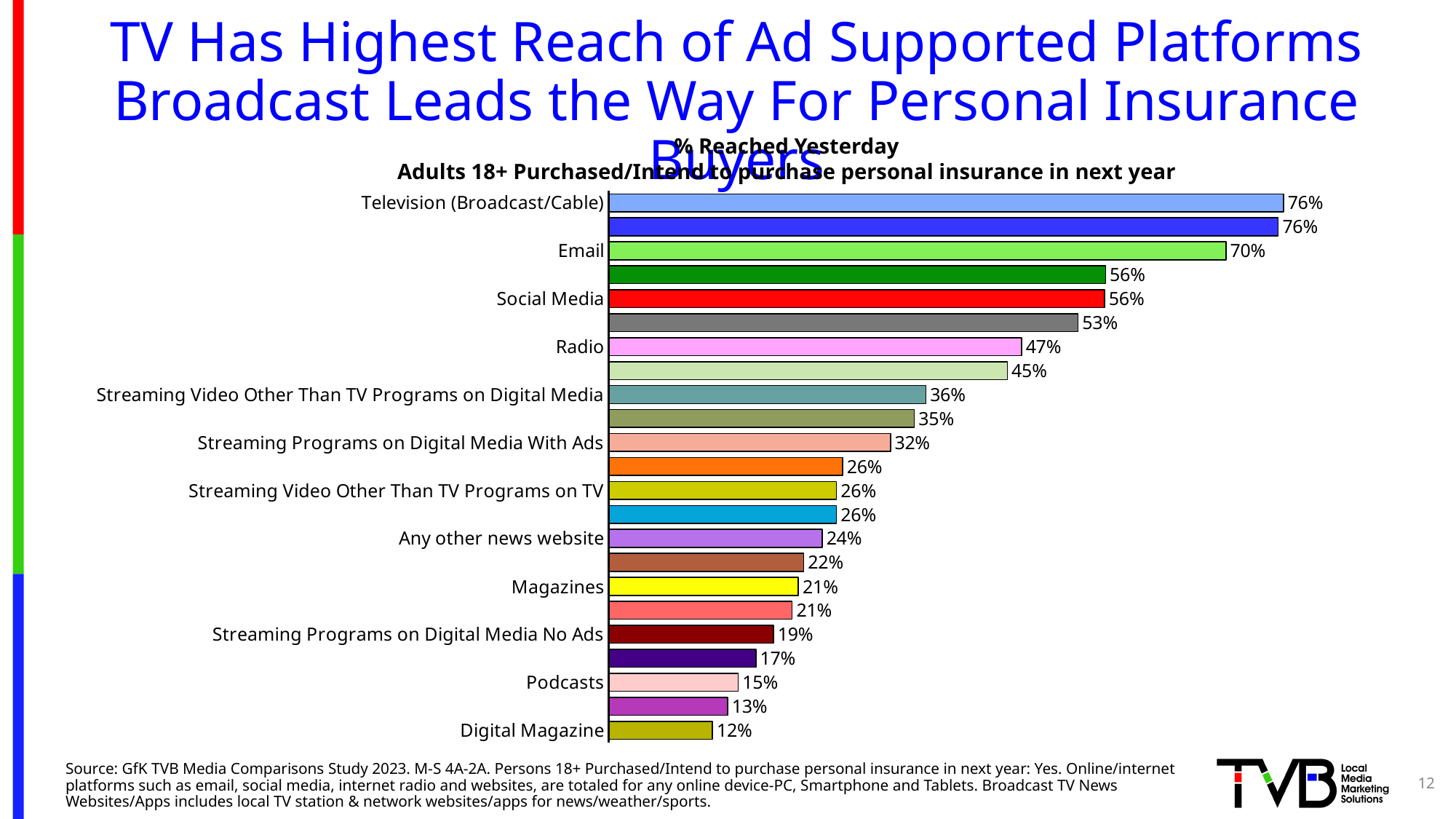
Do the bar values increase or decrease from the top of the chart to the bottom? decrease What is the value for Email? 70% What is the highest value shown on the chart? 76% Which labeled category has the lowest value? Digital Magazine What kind of chart is shown on the slide? bar chart What is the difference between the values for Email and Social Media? 14% What is the value for Podcasts? 15% What is the value for Streaming Programs on Digital Media With Ads? 32% What is the value for Radio? 47% How many bars are plotted on the chart? 23 What is the value for Television (Broadcast/Cable)? 76% Which is larger, the value for Magazines or the value for Any other news website? Any other news website